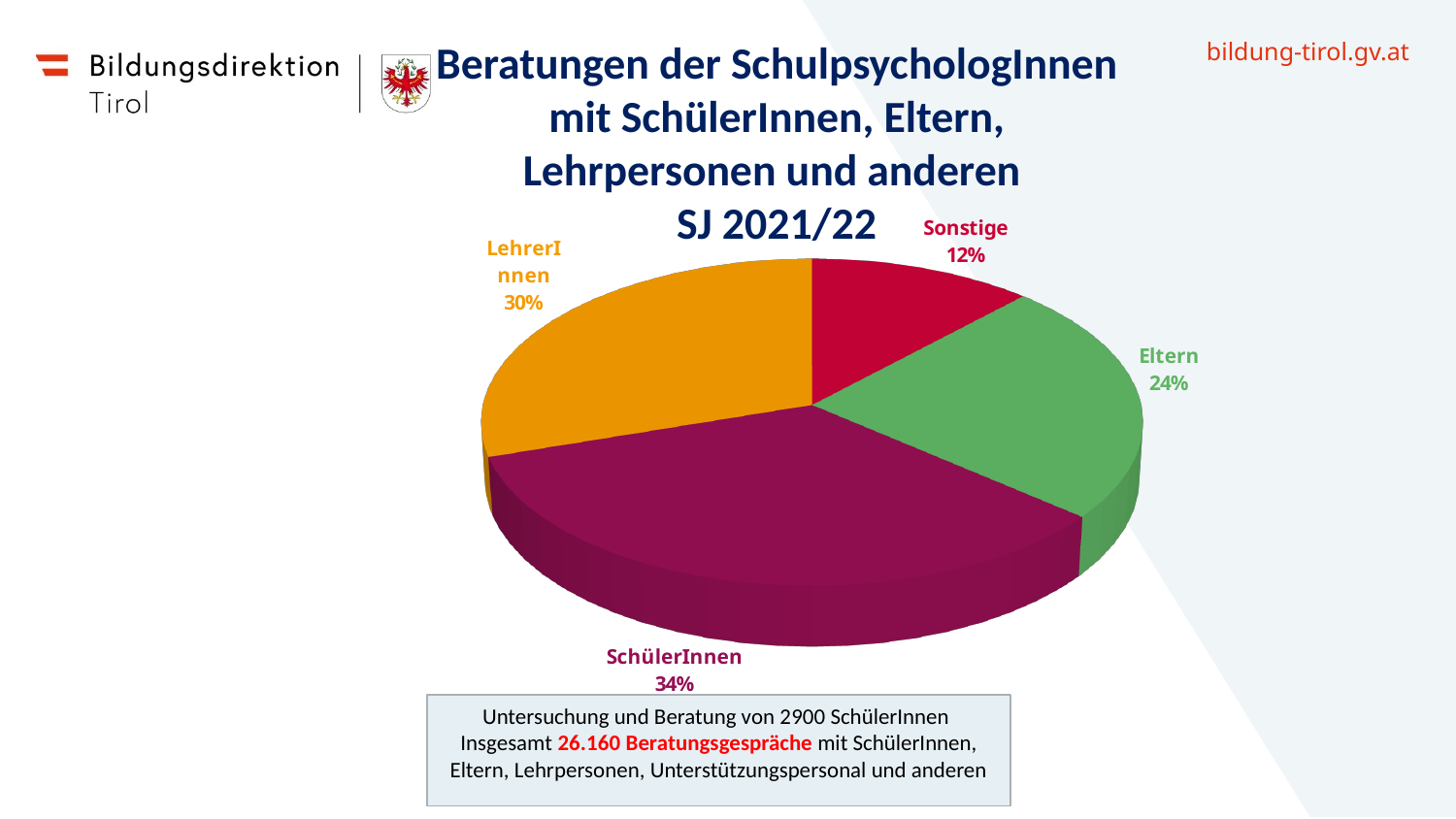
Which school year does the chart title refer to? SJ 2021/22 What is the difference in percentage points between the SchülerInnen and Eltern slices? 10 Which slice is larger, Eltern or Sonstige? Eltern Which category has the largest slice of the pie? SchülerInnen What share of the pie does Eltern have? 24% How many slices does the pie chart have? 4 What share of the pie does SchülerInnen have? 34% What share of the pie does Sonstige have? 12% Which category has the smallest slice of the pie? Sonstige What kind of chart is shown on the slide? pie chart What is the combined share of the SchülerInnen and LehrerInnen slices? 64%